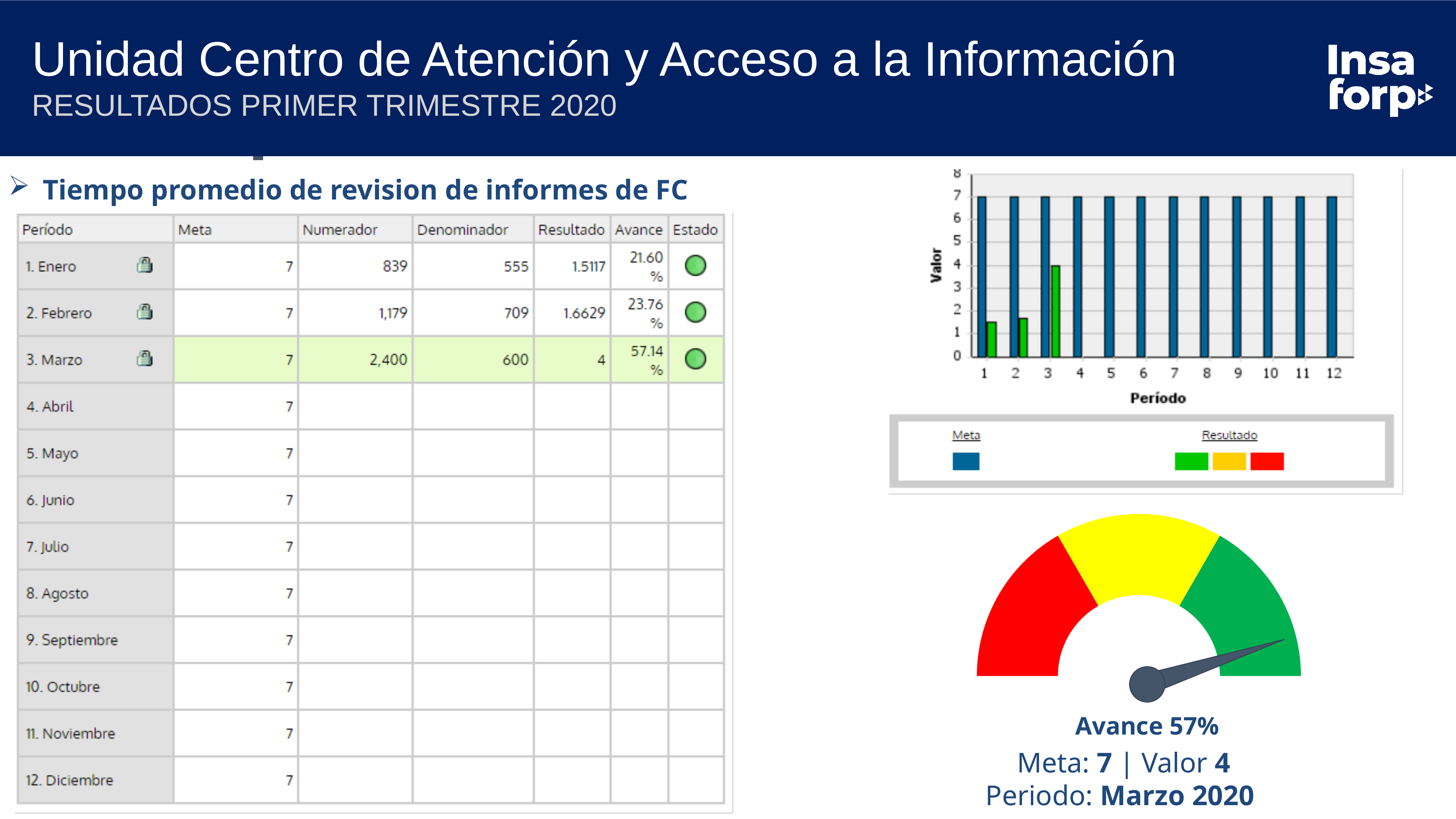
In the bar chart, is the Resultado value for período 2 greater or less than 2? less In the bar chart, what is the value of the Meta series for período 1? 7 In the bar chart, is the Resultado value for período 1 greater or less than 2? less In the bar chart, which período has the highest Resultado value? 3 In the bar chart, which is larger for período 3: the Meta value or the Resultado value? Meta How many períodos are shown on the x axis of the bar chart? 12 In the bar chart, what is the value of the Resultado series for período 3? 4 What kind of chart shows Meta and Resultado by Período? bar chart In the bar chart, what is the difference between the Meta value and the Resultado value for período 3? 3 Does the Resultado series rise or fall from período 1 to período 3 in the bar chart? rise In the bar chart, which período has the lowest Resultado value? 1 What Avance percentage does the gauge chart show? 57%